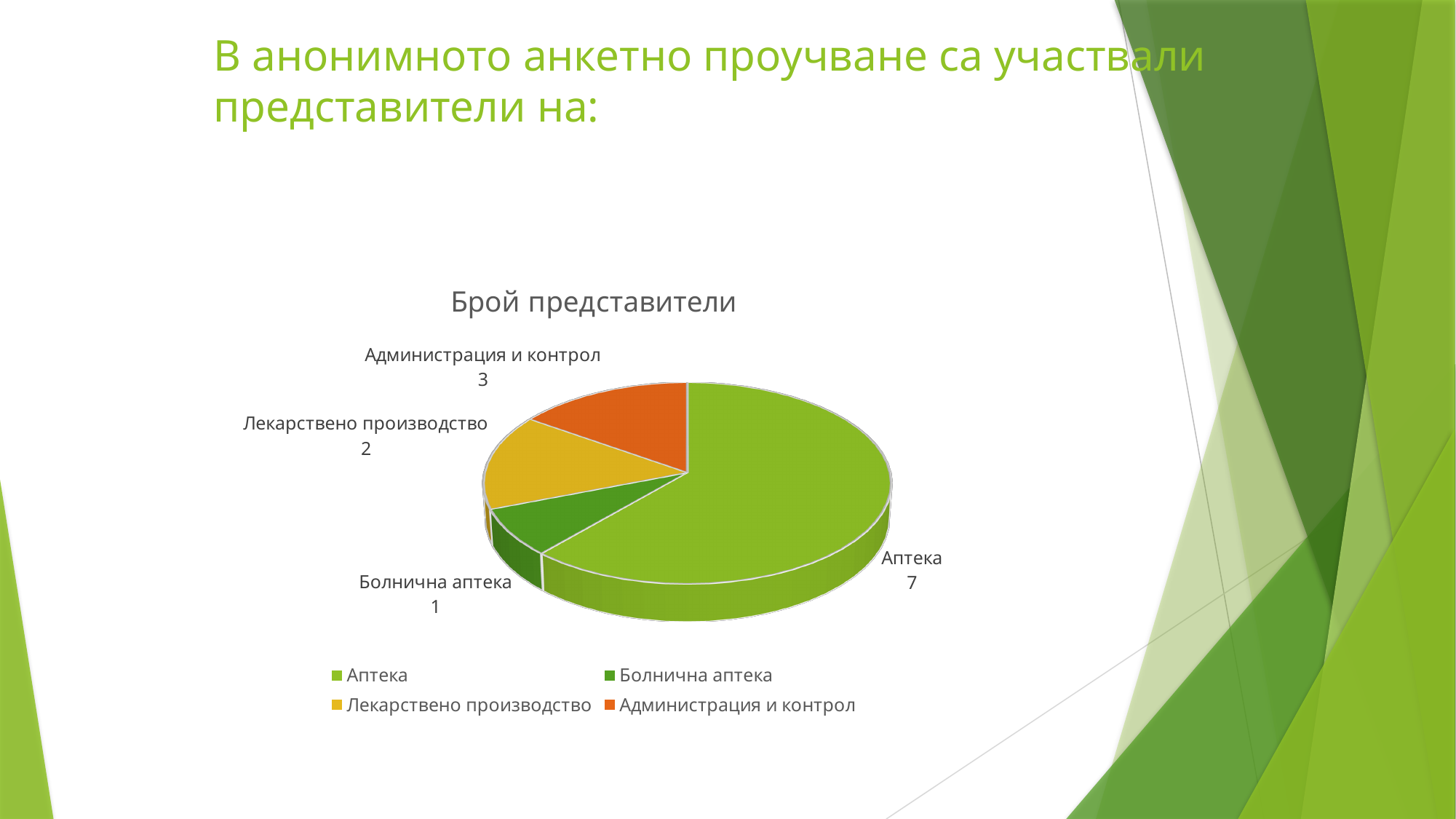
What is the value for Лекарствено производство? 2 What kind of chart is shown on the slide? pie chart How many categories are shown in the chart? 4 Which is larger, the value for Лекарствено производство or the value for Администрация и контрол? Администрация и контрол What is the value for Аптека? 7 What is the difference between the values for Аптека and Администрация и контрол? 4 What is the value for Администрация и контрол? 3 What is the title of the chart? Брой представители Which category has the highest value? Аптека Which category has the lowest value? Болнична аптека What is the value for Болнична аптека? 1 What share of the total does Аптека represent? 7/13